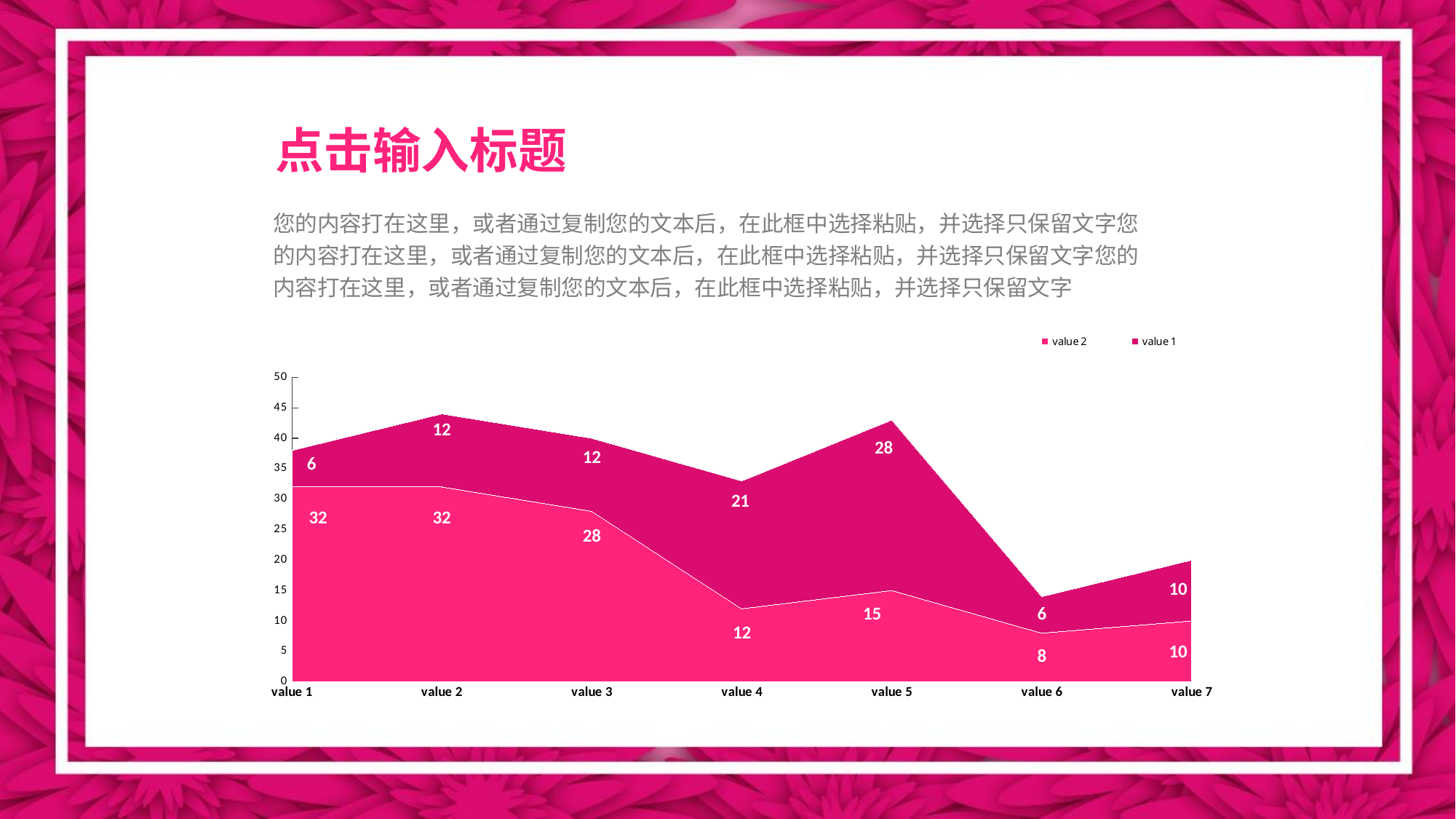
At category "value 3", which series has the larger value, "value 1" or "value 2"? value 2 What is the difference between the "value 1" series at "value 5" and at "value 1"? 22 How many categories are shown on the x axis? 7 What is the combined total of both series at category "value 2"? 44 What is the value of the "value 2" series at category "value 6"? 8 How many series does the legend list? 2 At which category is the "value 2" series lowest? value 6 What is the value of the "value 1" series at category "value 5"? 28 What is the value of the "value 2" series at category "value 1"? 32 Does the "value 2" series rise or fall from "value 1" to "value 4"? Fall What kind of chart is shown on the slide? Area chart At which category does the "value 1" series reach its highest value? value 5